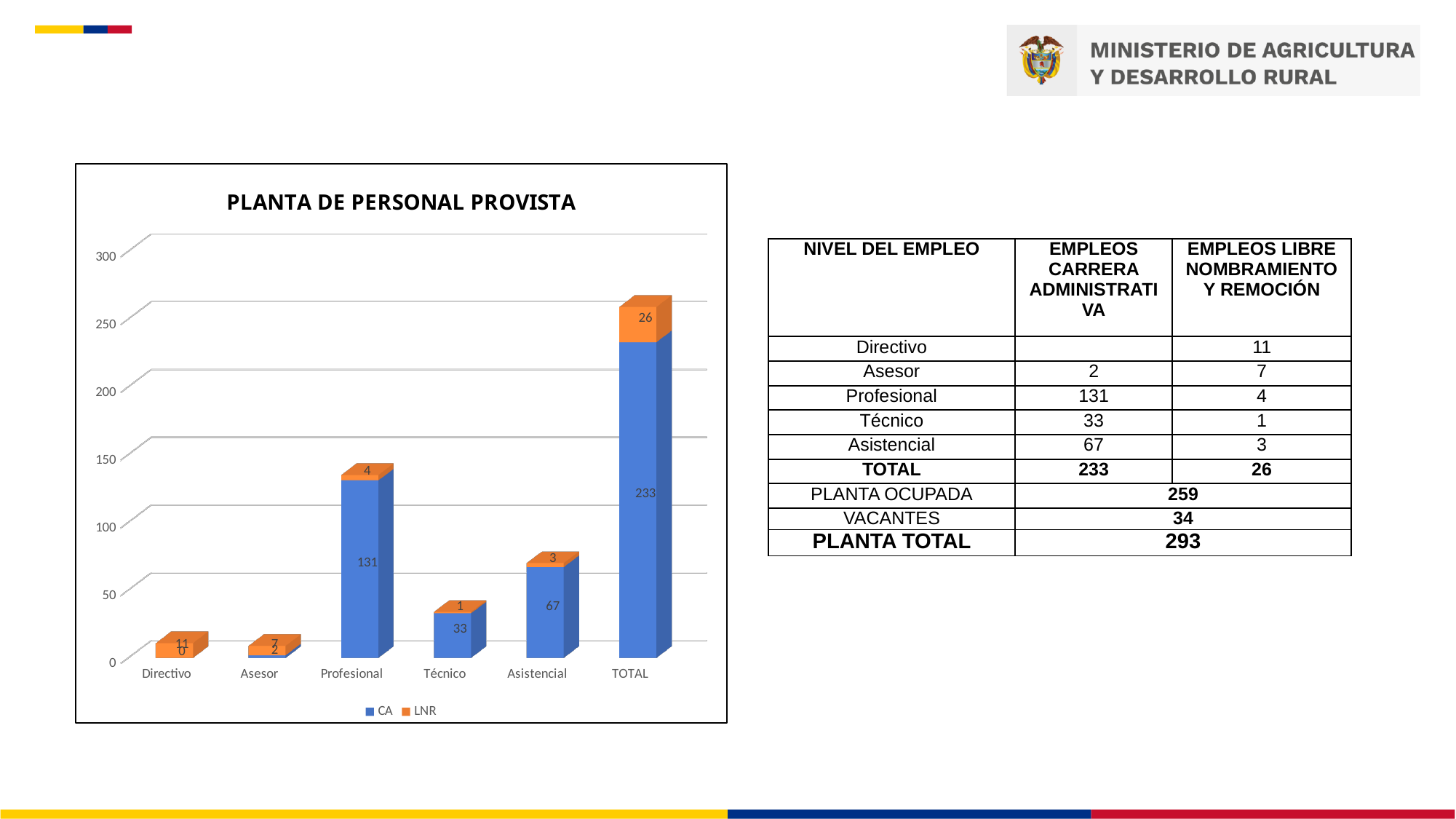
How many categories are shown on the x axis of the chart? 6 What is the total of the stacked bar for Asesor? 9 Which is larger, the CA value for Técnico or the CA value for Asistencial? Asistencial What is the difference between the CA values for Profesional and Asistencial? 64 Which category has the lowest LNR value? Técnico What is the CA value for Profesional in the chart? 131 What is the LNR value for TOTAL in the chart? 26 What is the CA value for Asistencial in the chart? 67 What is the LNR value for Directivo in the chart? 11 Excluding the TOTAL bar, which category has the highest CA value? Profesional What type of chart is shown on the slide? Stacked bar chart How many series does the chart legend list? 2